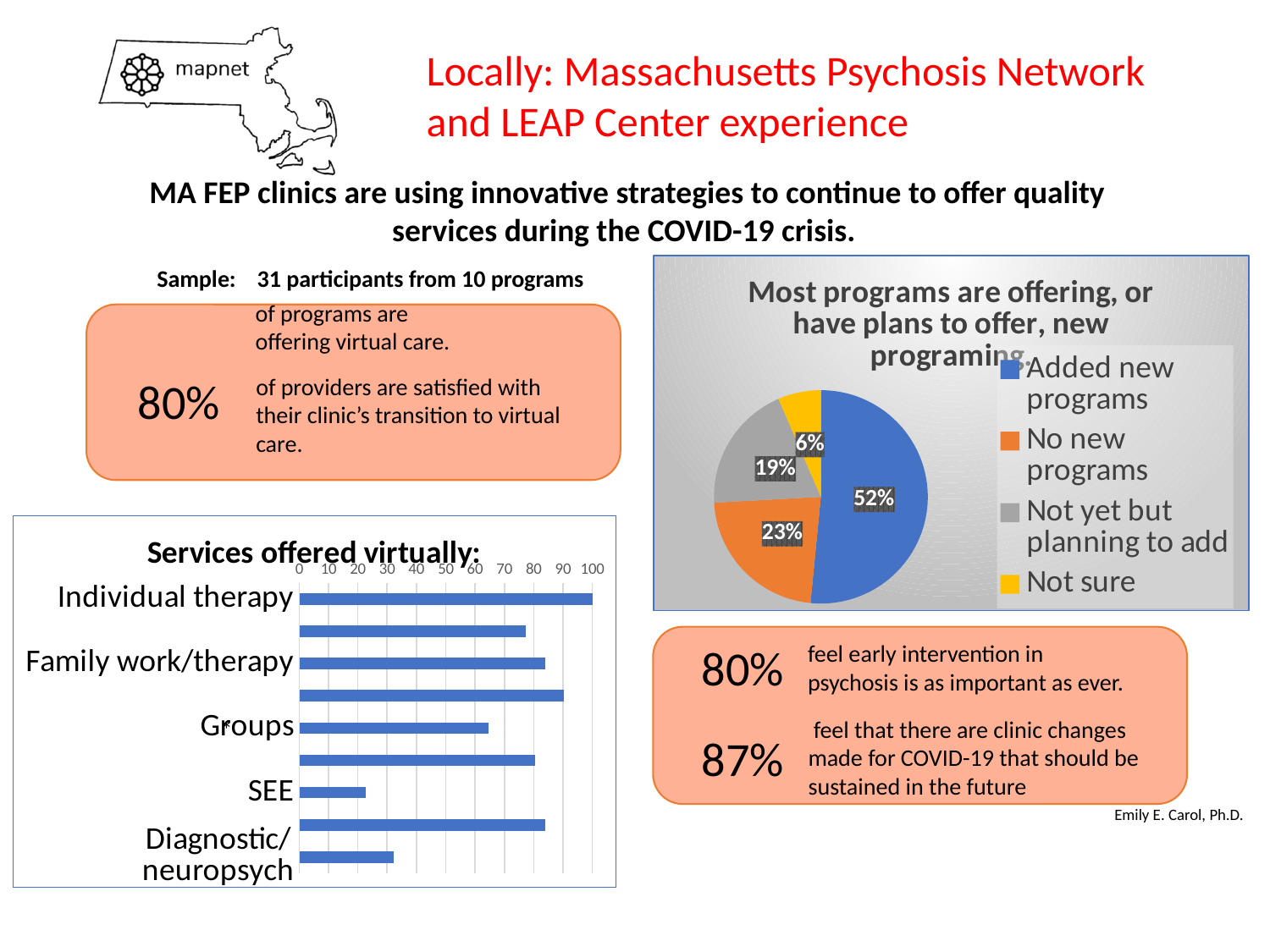
How many categories does the legend of the pie chart on the right list? 4 In the pie chart on the right, what percentage of programs answered 'Not sure'? 6% In the 'Services offered virtually:' chart, which has the larger value, Individual therapy or Groups? Individual therapy In the pie chart on the right, which category has the largest slice? Added new programs In the pie chart on the right, which category has the smallest slice? Not sure In the 'Services offered virtually:' chart, is the value for Family work/therapy greater or less than 70? greater In the pie chart on the right, what percentage is shown for 'Not yet but planning to add'? 19% What kind of chart is 'Services offered virtually:'? Bar chart In the 'Services offered virtually:' chart, is the value for SEE greater or less than 30? less In the pie chart titled 'Most programs are offering, or have plans to offer, new programing', what percentage of programs added new programs? 52% In the pie chart on the right, how many percentage points larger is 'Added new programs' than 'No new programs'? 29 percentage points In the pie chart on the right, what share of programs reported no new programs? 23%